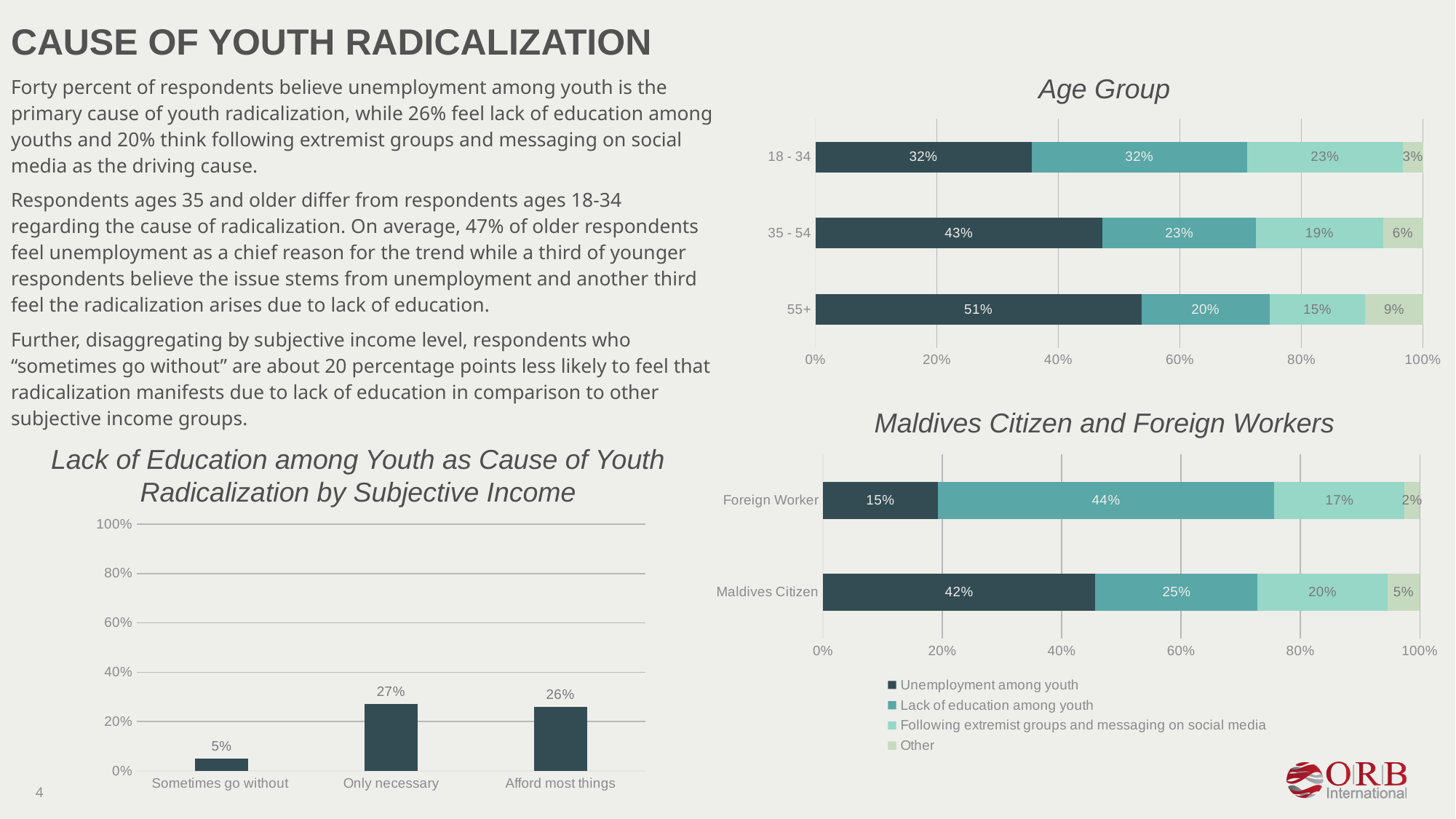
In the "Maldives Citizen and Foreign Workers" chart, what percentage of foreign workers cite lack of education among youth? 44% In the "Age Group" chart, what is the difference between the 35 - 54 and 18 - 34 groups for unemployment among youth? 11 percentage points In the "Age Group" chart, how many age groups are shown? 3 In the "Maldives Citizen and Foreign Workers" chart, which group has the larger share citing unemployment among youth, Foreign Worker or Maldives Citizen? Maldives Citizen In the "Maldives Citizen and Foreign Workers" chart, what is the "Other" value for Maldives Citizen? 5% What kind of chart is the "Lack of Education among Youth as Cause of Youth Radicalization by Subjective Income" chart? Bar chart In the "Age Group" chart, which age group has the highest share citing unemployment among youth? 55+ How many series does the legend list for the "Maldives Citizen and Foreign Workers" chart? 4 In the "Lack of Education among Youth as Cause of Youth Radicalization by Subjective Income" chart, what is the value for "Sometimes go without"? 5% In the "Age Group" chart, what percentage of respondents aged 55+ cite unemployment among youth? 51% In the "Lack of Education among Youth as Cause of Youth Radicalization by Subjective Income" chart, which category has the highest value? Only necessary In the "Age Group" chart, what percentage of respondents aged 18 - 34 cite lack of education among youth? 32%